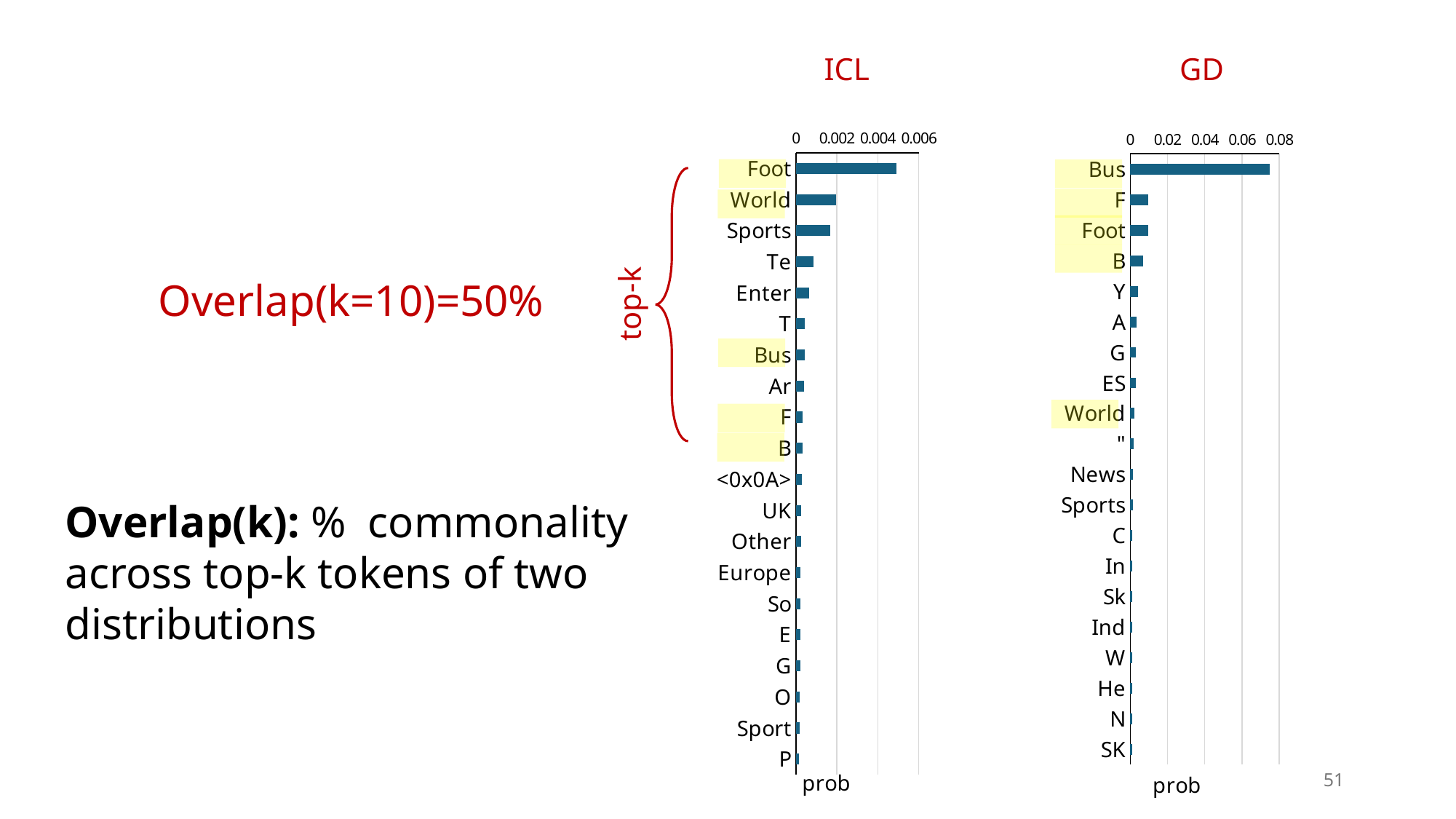
In the GD chart, which is larger, the value for Bus or the value for Foot? Bus In the GD chart, which category has the highest value? Bus In the ICL chart, which category has the highest value? Foot How many categories are shown in the GD chart? 20 In the GD chart, is the value for F greater or less than 0.02? less How many categories are shown in the ICL chart? 20 What is the x-axis label of the GD chart? prob What kind of chart is the ICL chart? bar chart In the ICL chart, is the value for Foot greater or less than 0.004? greater In the ICL chart, which is larger, the value for Foot or the value for World? Foot In the GD chart, is the value for Bus greater or less than 0.06? greater